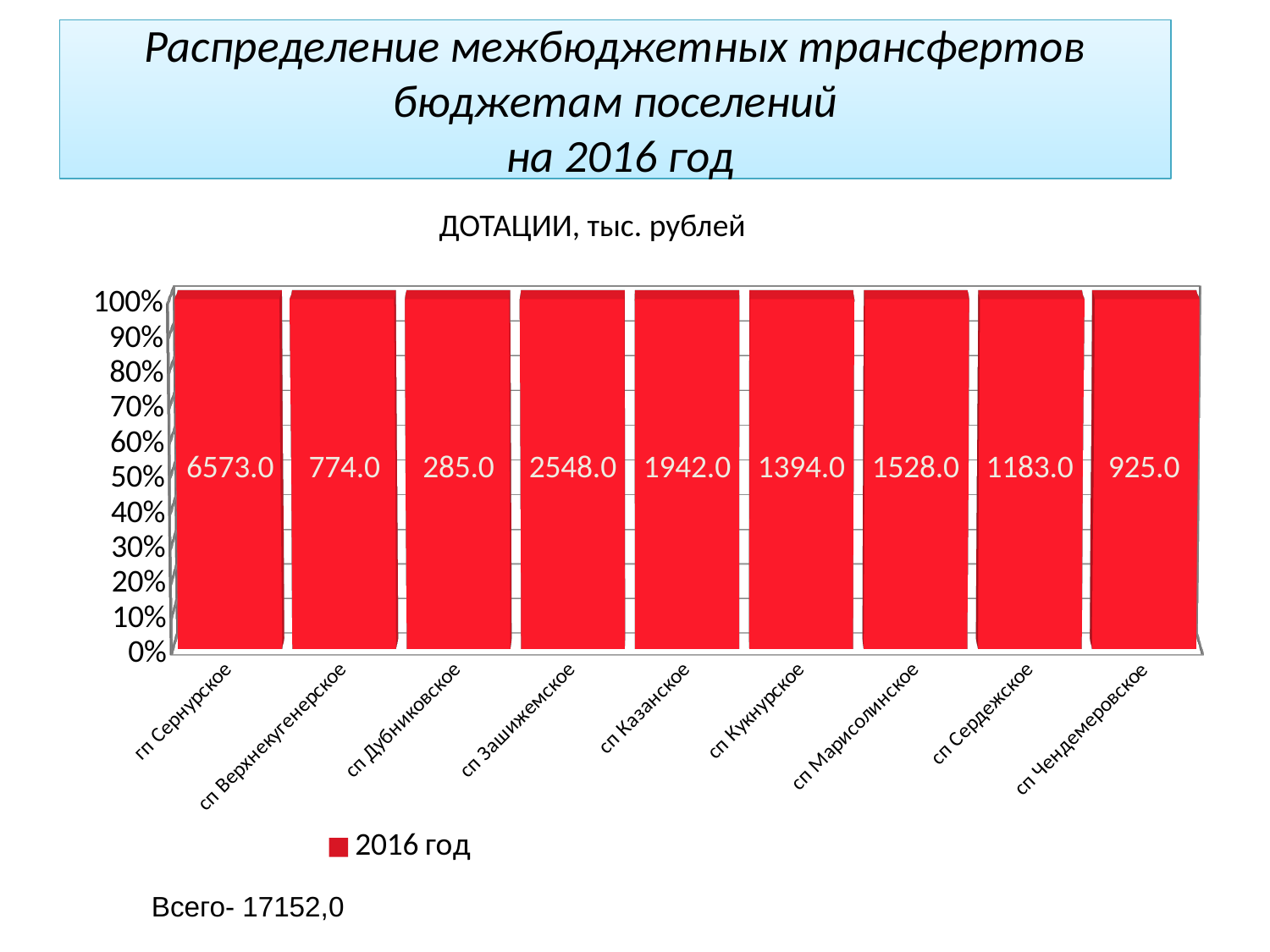
How many categories are shown on the x axis? 9 Which category has the lowest labelled value? сп Дубниковское How many series does the legend list? 1 What is the data label value for сп Зашижемское? 2548.0 What is the data label value for сп Кукнурское? 1394.0 What is the data label value for сп Чендемеровское? 925.0 What kind of chart is shown? bar chart Which has the larger labelled value, сп Марисолинское or сп Сердежское? сп Марисолинское Which category has the highest labelled value? гп Сернурское What is the data label value for гп Сернурское? 6573.0 What is the title shown above the chart? ДОТАЦИИ, тыс. рублей What is the difference between the labelled values for сп Зашижемское and сп Казанское? 606.0